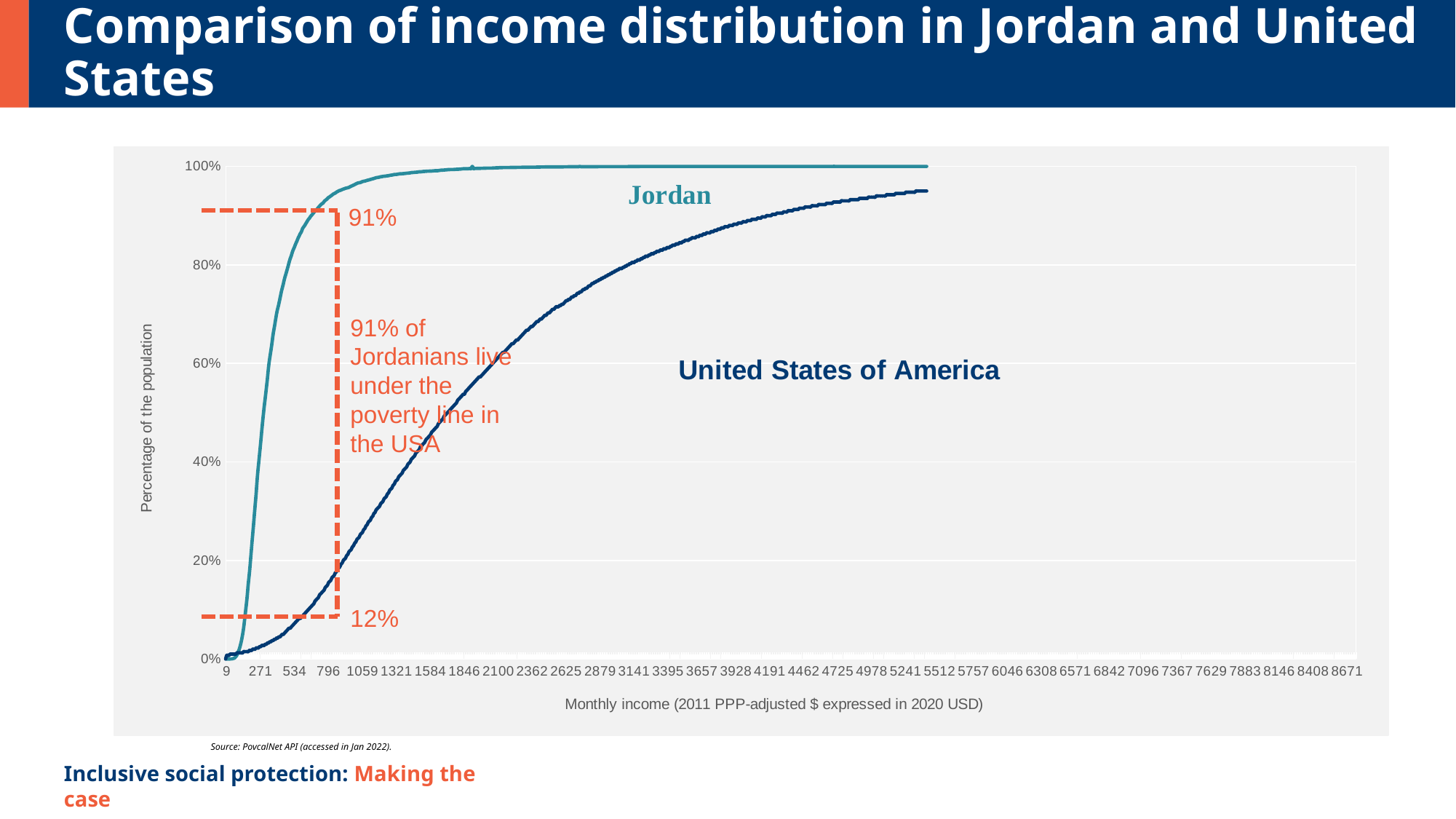
How many countries' curves are plotted on the chart? 2 Is the value of the United States of America curve at a monthly income of 1059 greater or less than 40%? less What is the label of the y axis? Percentage of the population According to the annotation, what percentage of the United States population lives under the US poverty line? 12% According to the annotation, what percentage of Jordanians live under the poverty line in the USA? 91% At the US poverty line, which country has the larger share of its population below that income, Jordan or the United States of America? Jordan Do the curves rise or fall as monthly income increases along the x axis? rise What kind of chart is shown on the slide? line chart Is the value of the Jordan curve at a monthly income of 796 greater or less than 80%? greater What is the label of the x axis? Monthly income (2011 PPP-adjusted $ expressed in 2020 USD) Is the value of the United States of America curve at a monthly income of 2625 greater or less than 40%? greater What is the difference in percentage points between the annotated Jordan value (91%) and the annotated United States value (12%) at the US poverty line? 79 percentage points